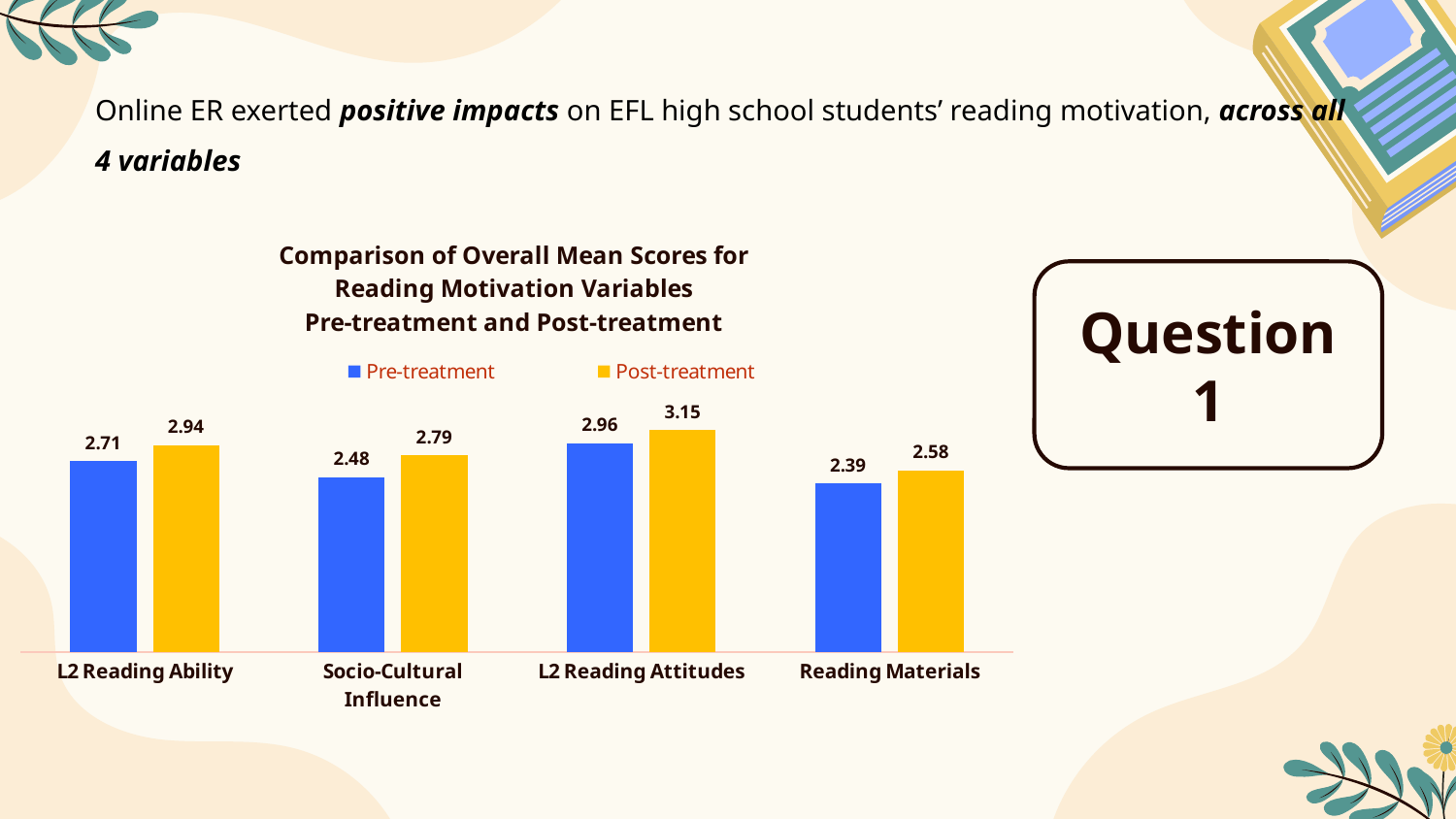
What is the difference between the Post-treatment and Pre-treatment mean scores for Socio-Cultural Influence? 0.31 How many series does the chart's legend list? 2 What is the Post-treatment mean score for Reading Materials? 2.58 Which variable has the highest Post-treatment mean score? L2 Reading Attitudes Which variable has the lowest Pre-treatment mean score? Reading Materials Which colour represents the Post-treatment series in the chart? Yellow What is the Pre-treatment mean score for L2 Reading Ability? 2.71 What kind of chart is shown on the slide? Bar chart What is the difference between the Post-treatment and Pre-treatment mean scores for L2 Reading Attitudes? 0.19 Which is larger: the Pre-treatment score for L2 Reading Ability or the Pre-treatment score for Socio-Cultural Influence? L2 Reading Ability How many variables (categories) are shown on the x axis of the chart? 4 What is the Post-treatment mean score for Socio-Cultural Influence? 2.79